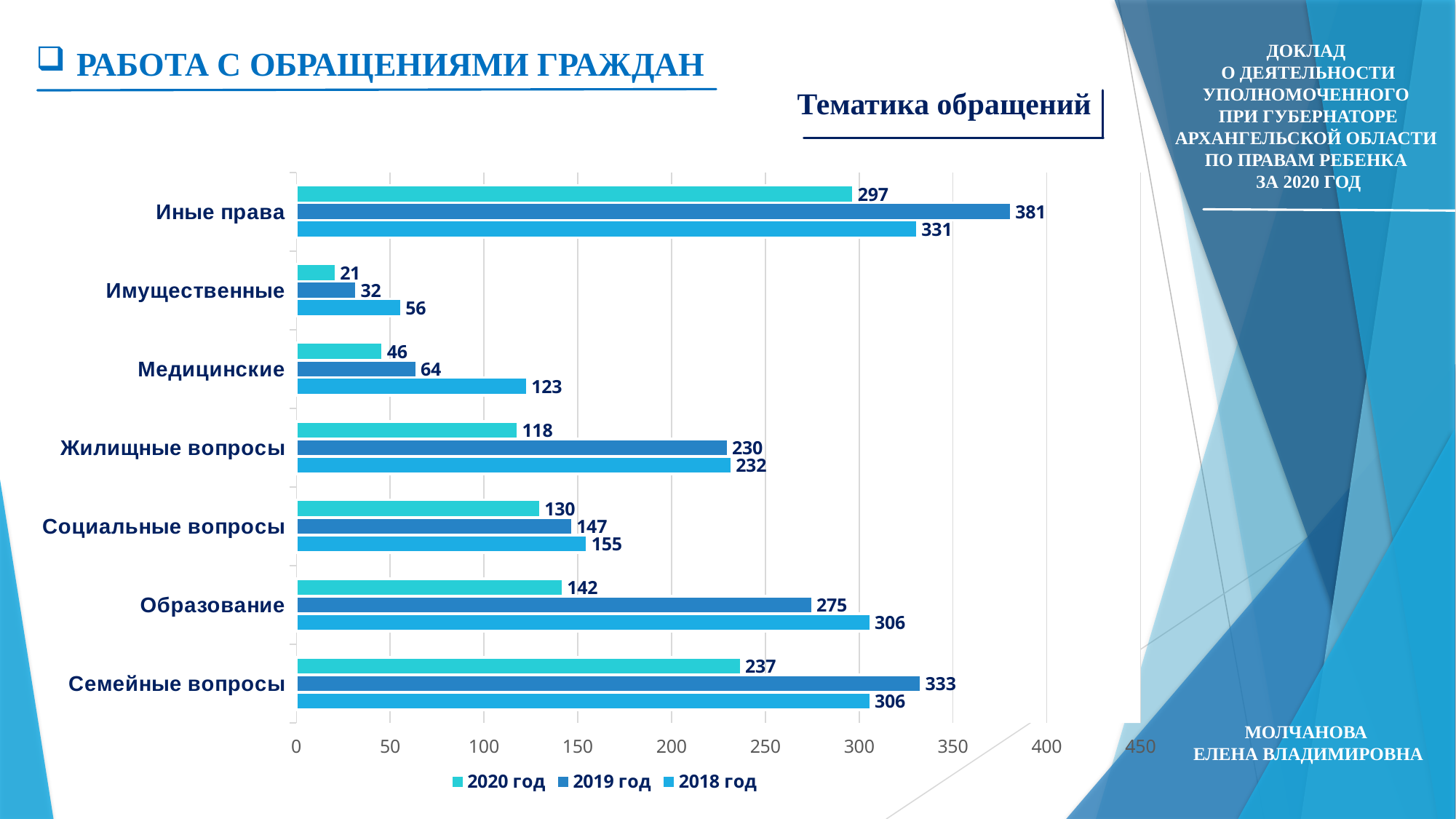
What is the value for Иные права in 2019 год? 381 What is the value for Медицинские in 2018 год? 123 What is the value for Семейные вопросы in 2020 год? 237 What is the difference between the 2018 год and 2019 год values for Социальные вопросы? 8 What is the difference between the 2019 год and 2020 год values for Образование? 133 Which category has the highest value in 2020 год? Иные права Which is larger for Жилищные вопросы: the 2018 год value or the 2020 год value? 2018 год Which category has the lowest value in 2018 год? Имущественные How many series does the legend list? 3 What is the title of the chart? Тематика обращений What type of chart is shown on the slide? bar chart How many categories are shown on the chart? 7